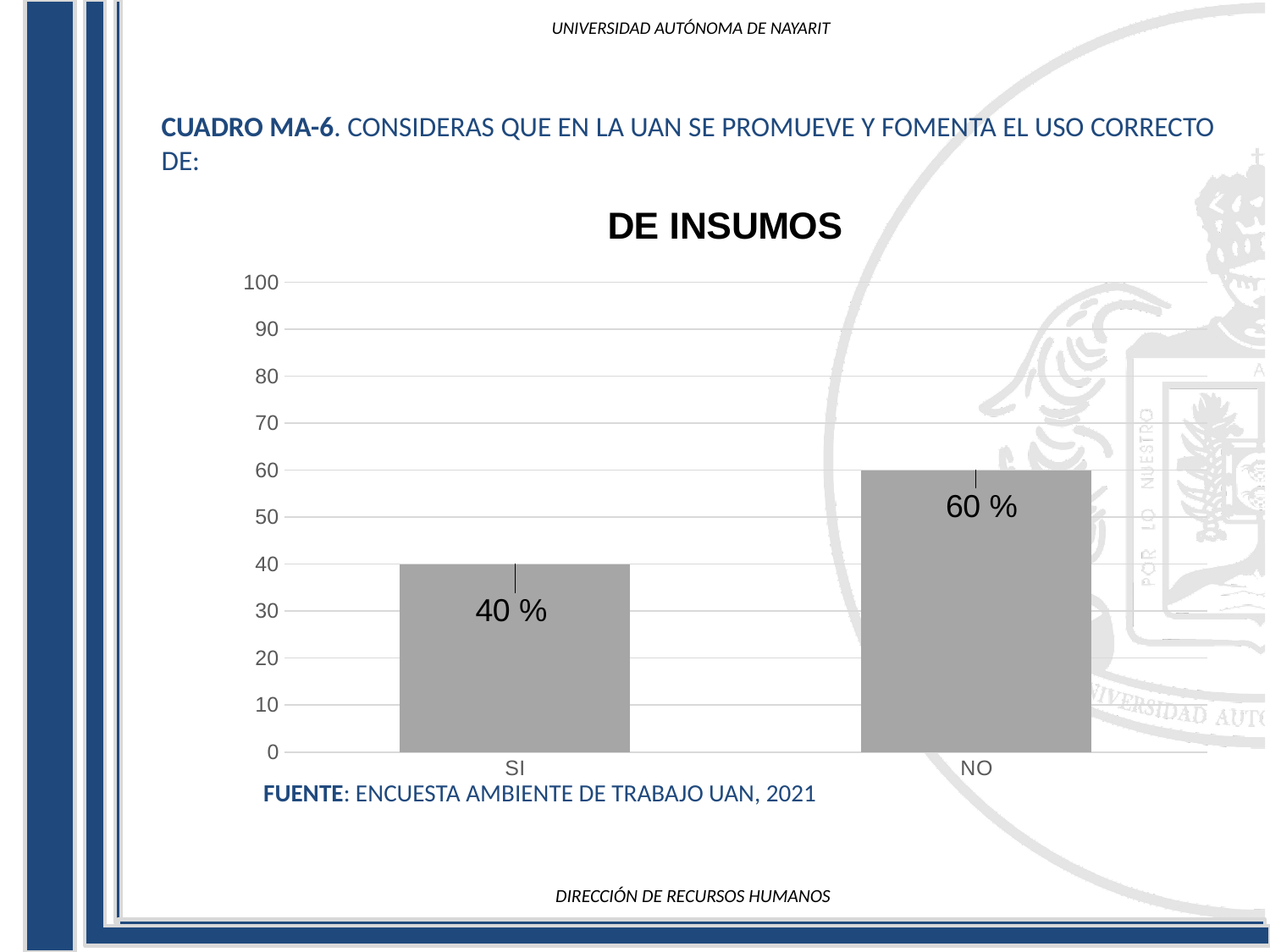
What is the title of the chart on the slide? DE INSUMOS Which is larger in the DE INSUMOS chart, the value for SI or the value for NO? NO What is the maximum value shown on the vertical axis of the DE INSUMOS chart? 100 Which category has the lowest value in the DE INSUMOS chart? SI What is the value for NO in the DE INSUMOS chart? 60 % How many categories are shown in the DE INSUMOS chart? 2 Is the value for SI greater or less than 50 in the DE INSUMOS chart? less What is the value for SI in the DE INSUMOS chart? 40 % What is the difference between the values for NO and SI in the DE INSUMOS chart? 20 % What kind of chart is the DE INSUMOS chart? bar chart Which category has the highest value in the DE INSUMOS chart? NO Is the value for NO greater or less than 50 in the DE INSUMOS chart? greater